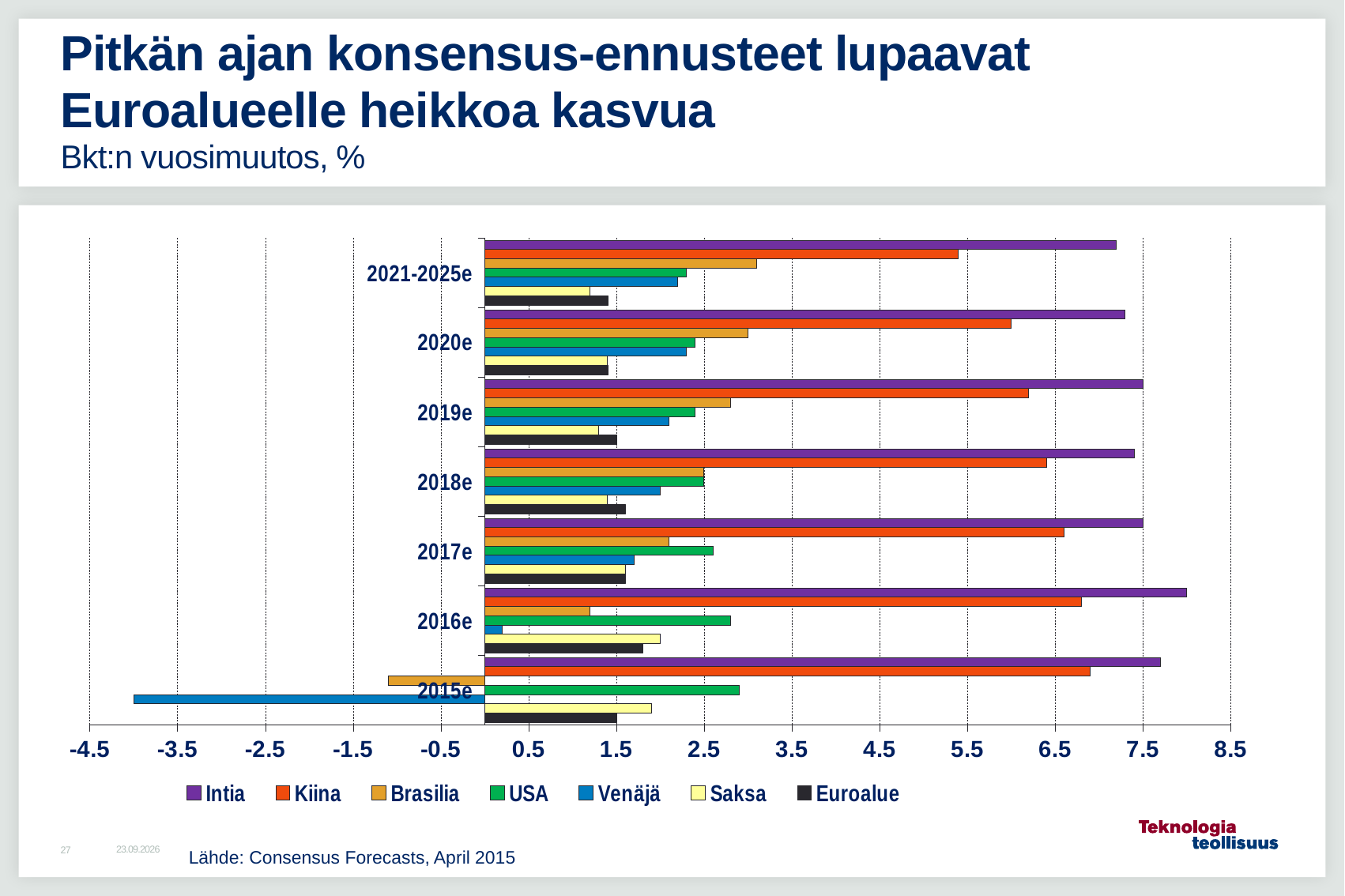
Which country has the highest value in 2016e? Intia What kind of chart is shown on the slide? bar chart How many time-period categories are shown on the chart? 7 How many series does the legend list? 7 Is the value for Brasilia in 2021-2025e greater or less than 2.5? greater Which is larger in 2017e, the value for Intia or the value for Kiina? Intia Which is larger in 2016e, the value for Venäjä or the value for Saksa? Saksa Do the values for Kiina rise or fall from 2015e to 2021-2025e? fall Which country has the lowest value in 2015e? Venäjä Is the value for Venäjä in 2015e greater or less than -3.5? less Is the value for Brasilia in 2015e greater or less than -0.5? less